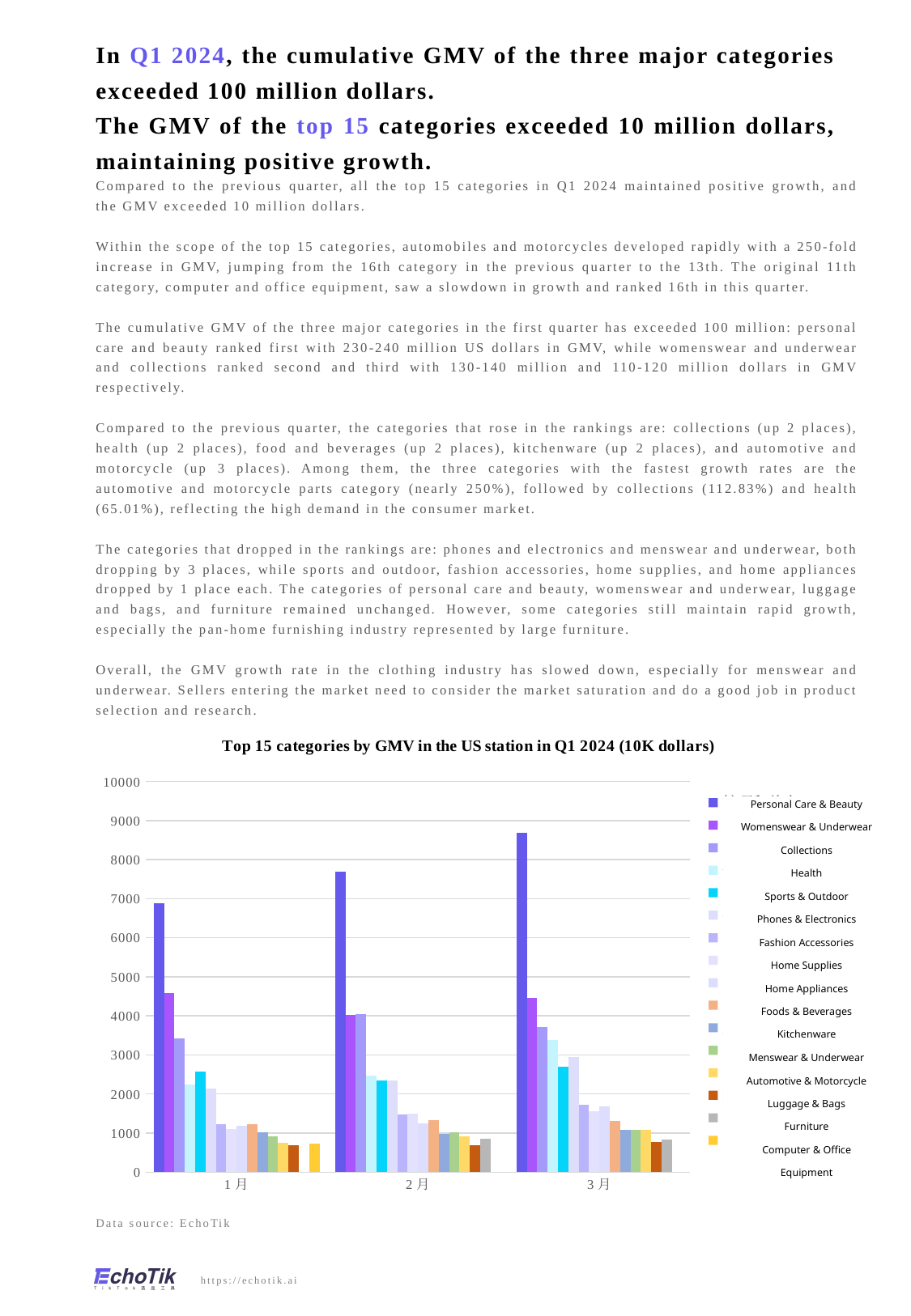
Is the value for Personal Care & Beauty in 3月 greater or less than 8000? greater How many month groups are shown on the x axis of the chart? 3 In which month is the Personal Care & Beauty bar the highest? 3月 In 1月, which is larger: Personal Care & Beauty or Womenswear & Underwear? Personal Care & Beauty Does the value for Personal Care & Beauty rise or fall from 1月 to 3月? rise Is the value for Personal Care & Beauty in 1月 greater or less than 6000? greater What is the title of the chart? Top 15 categories by GMV in the US station in Q1 2024 (10K dollars) What kind of chart is shown on the slide? bar chart Which category has the tallest bar in the 3月 group? Personal Care & Beauty How many series does the chart's legend list? 16 Is the value for Health in 3月 greater or less than 3000? greater